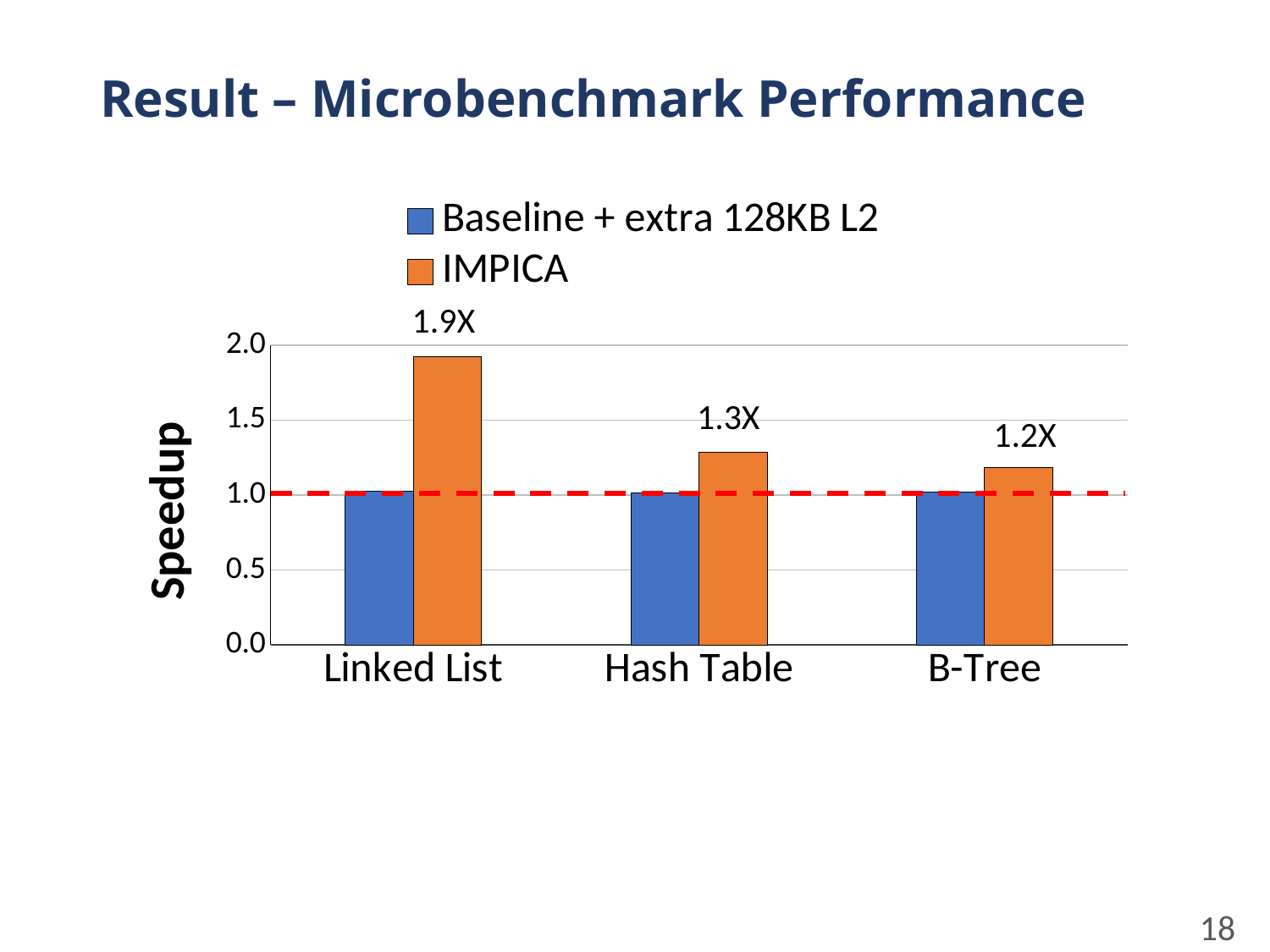
What is the label of the y axis? Speedup Is the IMPICA speedup for B-Tree greater or less than 1.5? less What is the IMPICA speedup for Hash Table? 1.3X What is the IMPICA speedup for Linked List? 1.9X Which benchmark has the lowest IMPICA speedup? B-Tree What kind of chart is shown on the slide? bar chart Which is larger for Hash Table: the IMPICA bar or the Baseline + extra 128KB L2 bar? IMPICA Is the IMPICA speedup for Linked List greater or less than 1.5? greater How many series does the legend list? 2 Which benchmark has the highest IMPICA speedup? Linked List How many benchmarks are shown on the x axis? 3 What is the IMPICA speedup for B-Tree? 1.2X